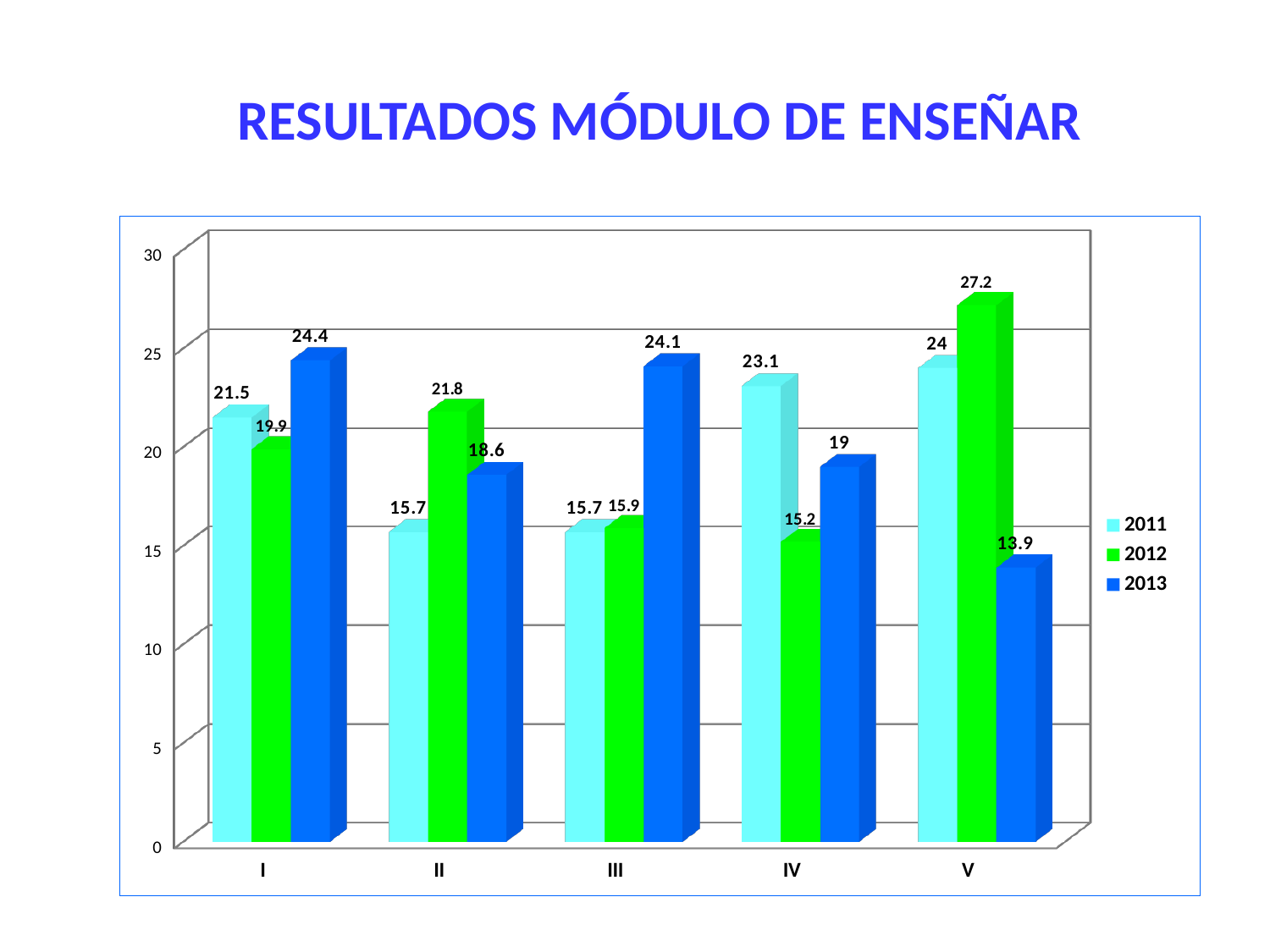
Which is larger in category II: the 2012 value or the 2013 value? 2012 What kind of chart is shown on the slide? Bar chart Which series is shown in green in the legend? 2012 Which category has the highest value for the 2012 series? V How many series does the legend list? 3 How many categories are shown on the x axis? 5 What is the value for 2012 in category V? 27.2 What is the title of the slide? RESULTADOS MÓDULO DE ENSEÑAR What is the difference between the 2013 and 2011 values in category III? 8.4 Which category has the lowest value for the 2013 series? V What is the value for 2013 in category I? 24.4 What is the value for 2011 in category IV? 23.1